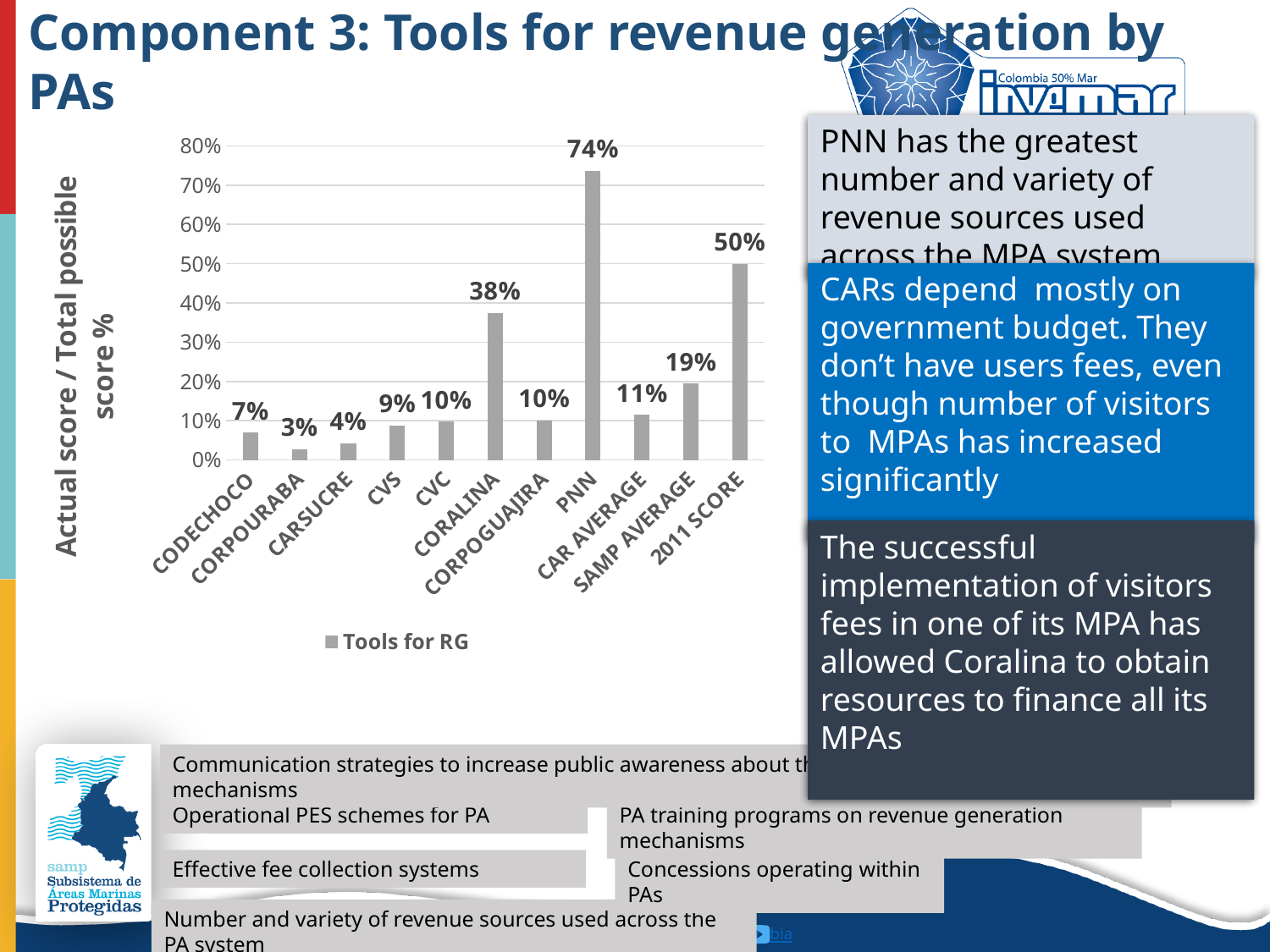
How many categories are shown on the x axis? 11 What is the value for PNN? 74% What is the difference between the values for PNN and 2011 SCORE? 24% What is the legend entry for the series? Tools for RG How many series does the legend list? 1 Which is larger, the value for CAR AVERAGE or the value for SAMP AVERAGE? SAMP AVERAGE What is the value for 2011 SCORE? 50% Which category has the highest value? PNN What is the value for CORALINA? 38% What is the value for SAMP AVERAGE? 19% What kind of chart is shown? Bar chart Which category has the lowest value? CORPOURABA